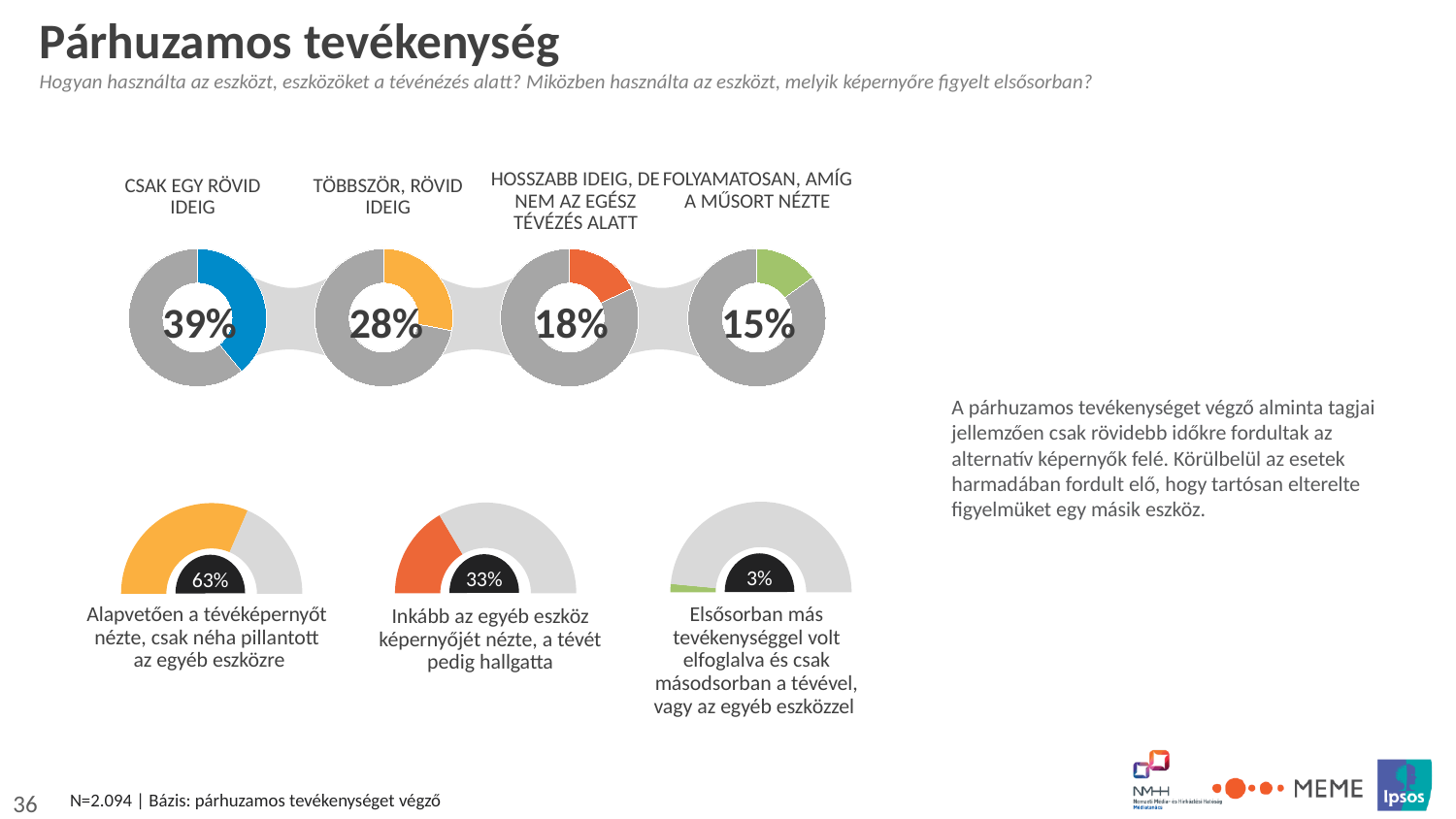
In the top row of donut charts, which category has the highest value? Csak egy rövid ideig In the top row of donut charts, what is the value for "Hosszabb ideig, de nem az egész tévézés alatt"? 18% In the top row of donut charts, what is the value for "Csak egy rövid ideig"? 39% In the top row of donut charts, what is the difference between "Csak egy rövid ideig" and "Többször, rövid ideig"? 11% In the top row of donut charts, which category has the lowest value? Folyamatosan, amíg a műsort nézte In the top row of donut charts, what is the value for "Folyamatosan, amíg a műsort nézte"? 15% In the bottom row of half-donut charts, what is the value for "Inkább az egyéb eszköz képernyőjét nézte, a tévét pedig hallgatta"? 33% How many donut charts are in the top row? 4 In the bottom row of half-donut charts, what is the value for "Alapvetően a tévéképernyőt nézte, csak néha pillantott az egyéb eszközre"? 63% In the bottom row of half-donut charts, which is larger: "Alapvetően a tévéképernyőt nézte" or "Inkább az egyéb eszköz képernyőjét nézte"? Alapvetően a tévéképernyőt nézte In the top row of donut charts, what is the value for "Többször, rövid ideig"? 28% In the bottom row of half-donut charts, what is the value for "Elsősorban más tevékenységgel volt elfoglalva és csak másodsorban a tévével, vagy az egyéb eszközzel"? 3%